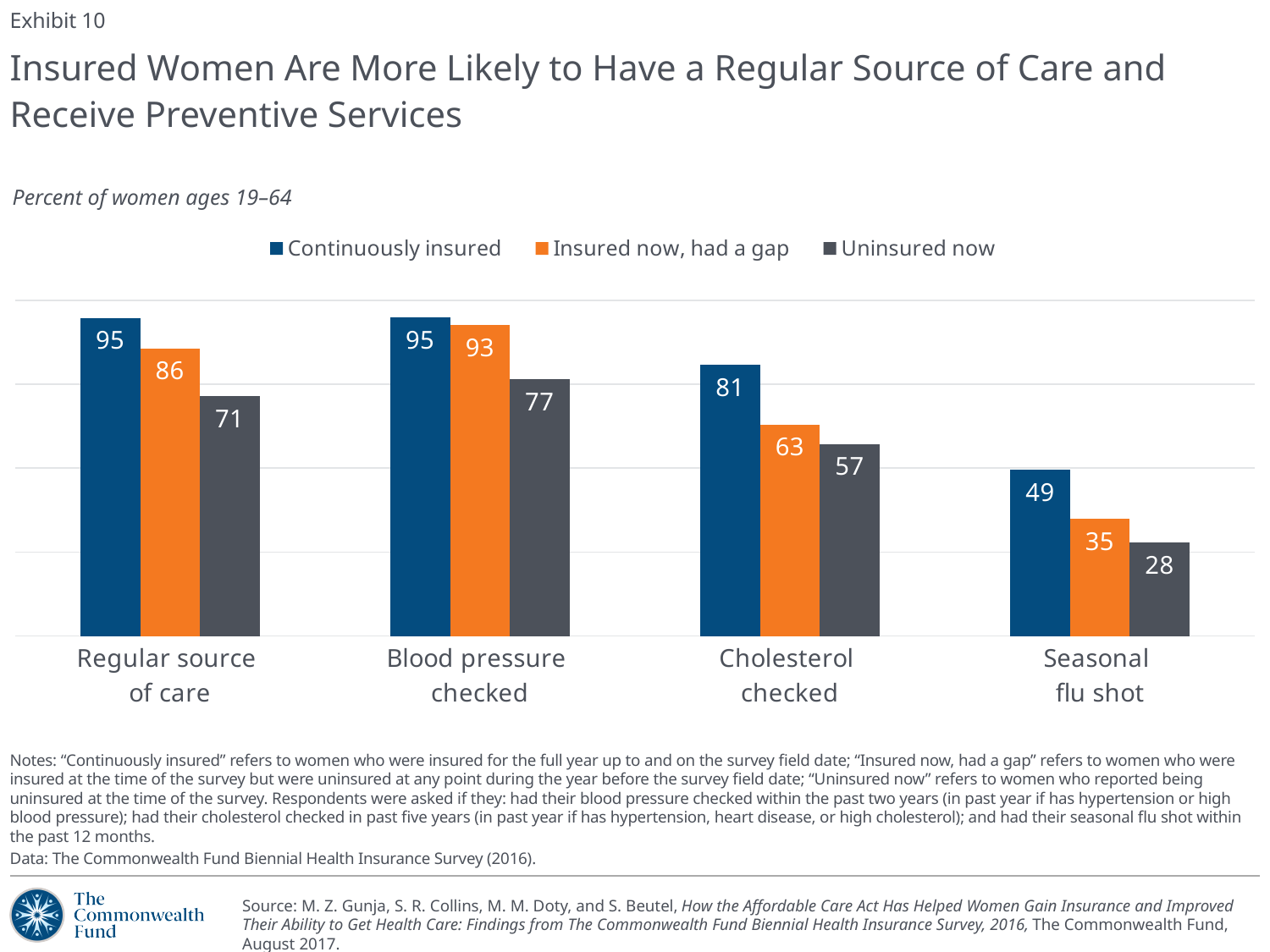
What kind of chart is shown on the slide? Bar chart What is the value for Uninsured now women who had a seasonal flu shot? 28 How many series does the legend list? 3 Which is larger: Insured now, had a gap for Blood pressure checked or Insured now, had a gap for Regular source of care? Blood pressure checked Do the values for the Continuously insured series rise or fall from left to right across the categories? Neither strictly; they stay at 95 for the first two categories, then fall (95, 95, 81, 49) What is the difference between Continuously insured and Uninsured now for Regular source of care? 24 How many categories are shown on the x axis? 4 What is the value for Continuously insured women with a regular source of care? 95 Which category has the lowest value for the Uninsured now series? Seasonal flu shot What is the value for Insured now, had a gap women who had their cholesterol checked? 63 Which series has the highest value for Blood pressure checked? Continuously insured What is the difference between Continuously insured and Insured now, had a gap for Cholesterol checked? 18